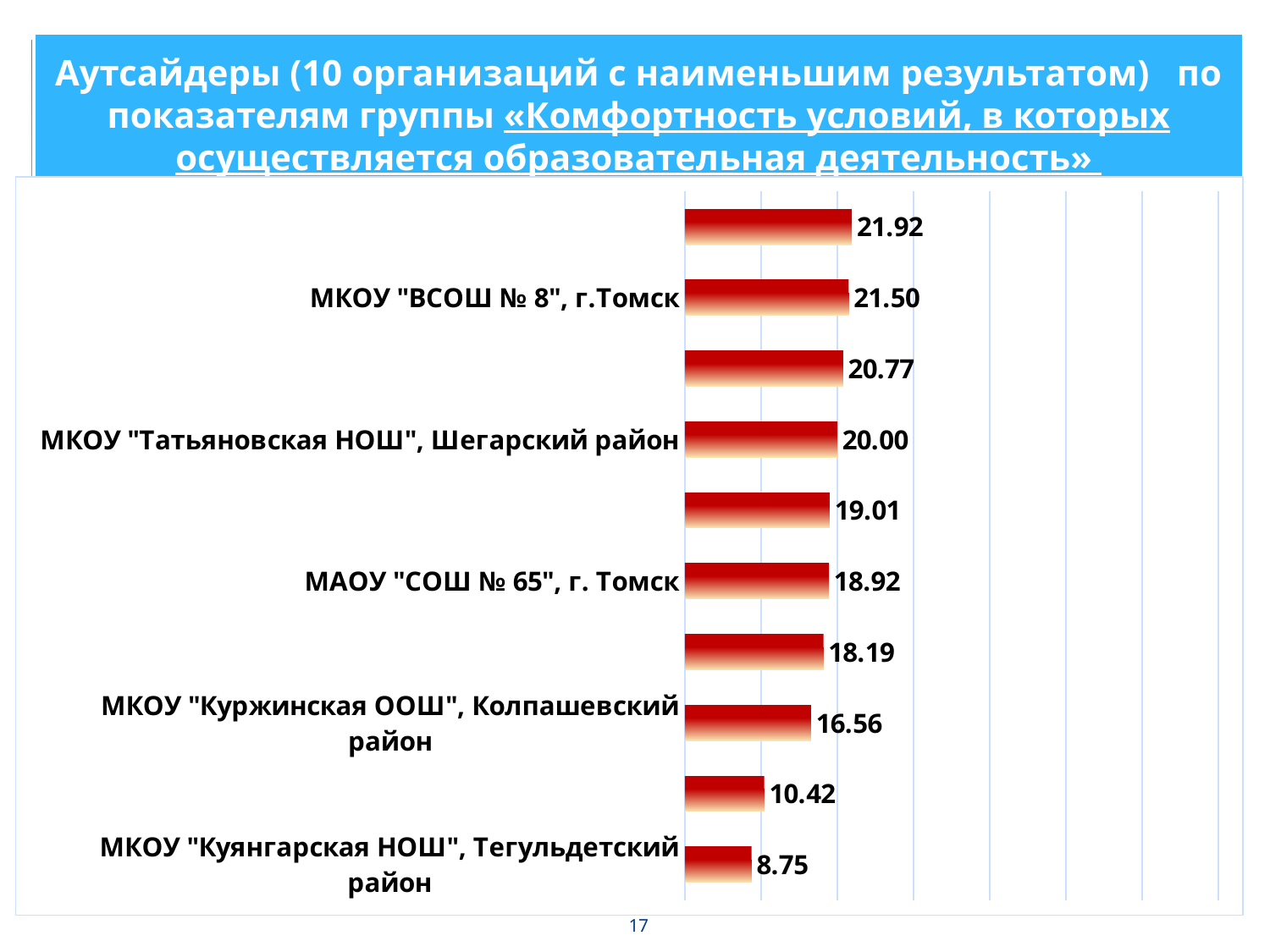
What is the largest value shown in the chart? 21.92 What is the value for МКОУ "Татьяновская НОШ", Шегарский район? 20.00 What is the value for МКОУ "Куянгарская НОШ", Тегульдетский район? 8.75 What type of chart is shown on the slide? bar chart Which is larger: the value for МКОУ "Татьяновская НОШ", Шегарский район or for МКОУ "Куржинская ООШ", Колпашевский район? МКОУ "Татьяновская НОШ", Шегарский район What is the value for МКОУ "Куржинская ООШ", Колпашевский район? 16.56 What is the value for МАОУ "СОШ № 65", г. Томск? 18.92 Do the bar values increase or decrease going from the top of the chart to the bottom? decrease Which labelled organisation has the lowest value in the chart? МКОУ "Куянгарская НОШ", Тегульдетский район What is the value for МКОУ "ВСОШ № 8", г.Томск? 21.50 What is the difference between the values for МКОУ "ВСОШ № 8", г.Томск and МКОУ "Куянгарская НОШ", Тегульдетский район? 12.75 How many bars are plotted in the chart? 10